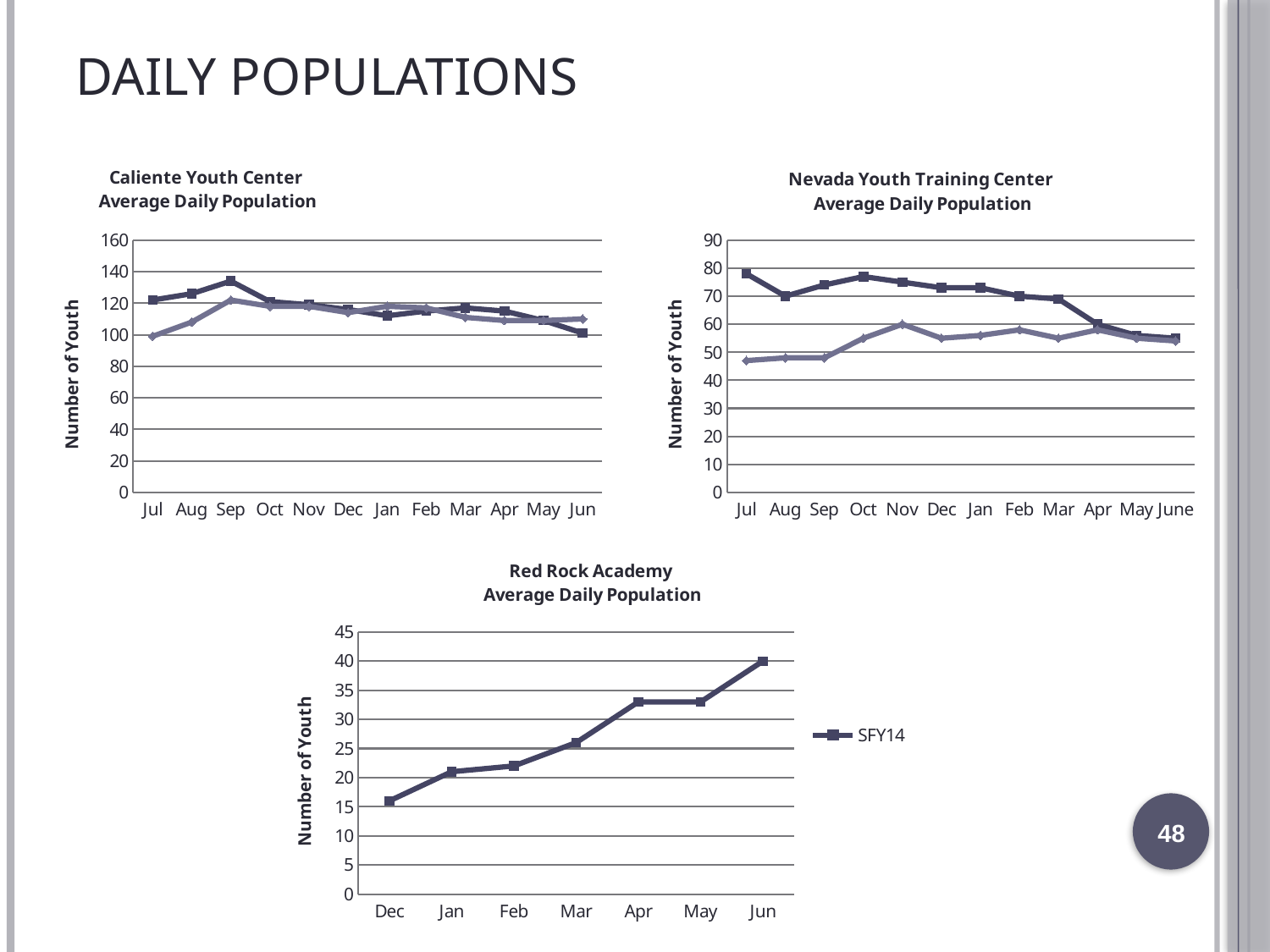
What kind of chart is the Caliente Youth Center Average Daily Population chart? line chart On the Red Rock Academy Average Daily Population chart, do the values rise or fall from Dec to Jun? rise On the Red Rock Academy Average Daily Population chart, is the value for Apr greater or less than 30? greater On the Nevada Youth Training Center Average Daily Population chart, is the highest value in Jul greater or less than 70? greater On the Red Rock Academy Average Daily Population chart, what is the value for Jun? 40 On the Nevada Youth Training Center Average Daily Population chart, does the upper line rise or fall from Jul to June? fall On the Caliente Youth Center Average Daily Population chart, in which month does the highest point occur? Sep On the Red Rock Academy Average Daily Population chart, which month has the highest value? Jun On the Red Rock Academy Average Daily Population chart, how many series does the legend list? 1 On the Nevada Youth Training Center Average Daily Population chart, how many months are shown on the x axis? 12 On the Red Rock Academy Average Daily Population chart, how many months are shown on the x axis? 7 On the Red Rock Academy Average Daily Population chart, which month has the lowest value? Dec